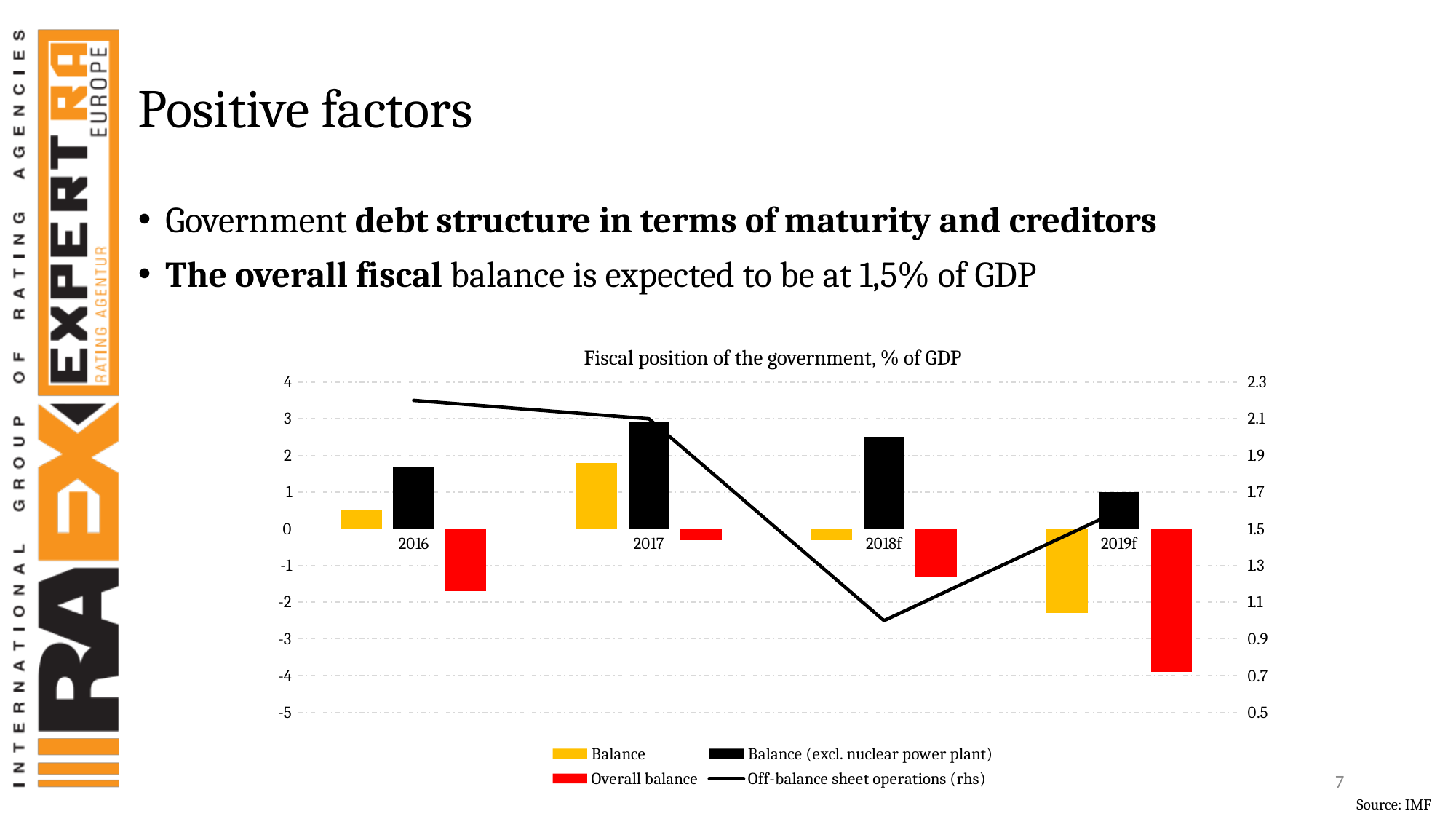
What is the title of the chart? Fiscal position of the government, % of GDP Is the Balance value for 2019f greater or less than -1? less Does the Off-balance sheet operations line rise or fall from 2016 to 2018f? It falls What kind of chart is shown on the slide? A combined bar and line chart Which is larger, the Balance value for 2016 or for 2017? 2017 In which year is the Balance bar the highest? 2017 Is the Overall balance value for 2019f greater or less than -3? less Is the Balance (excl. nuclear power plant) value for 2017 greater or less than 2? greater In which year is the Balance (excl. nuclear power plant) bar the highest? 2017 How many series does the legend of the chart list? 4 In which year is the Overall balance bar the lowest? 2019f How many years are shown on the x axis of the chart? 4